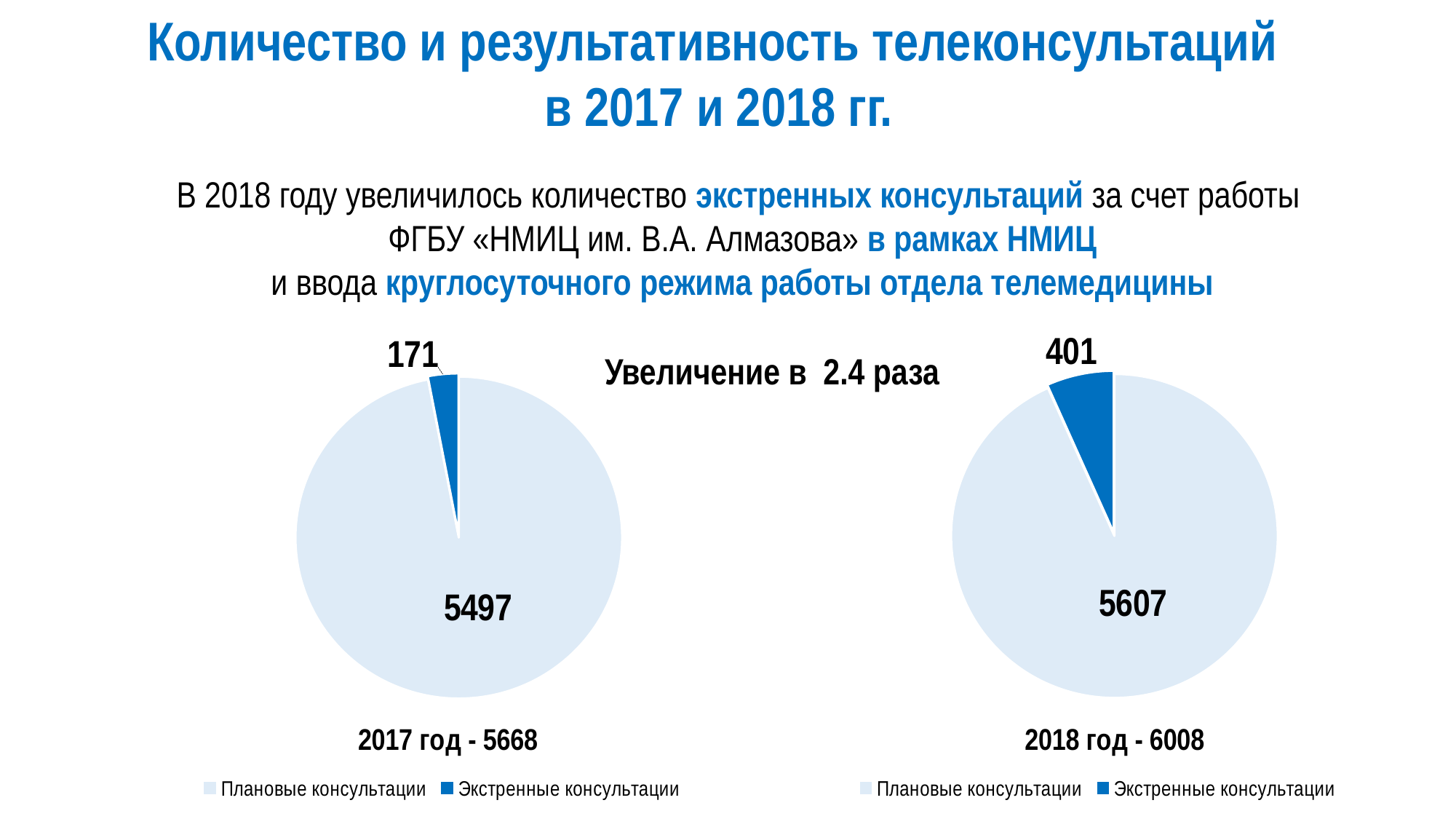
What type of chart is used on this slide for 2017 and 2018? Pie chart How many series does the legend of the 2017 pie chart list? 2 In the 2017 pie chart, which category is the smallest? Экстренные консультации What is the difference between the Экстренные консультации values in the 2018 and 2017 pie charts? 230 In the 2018 pie chart, which category is the largest? Плановые консультации What is the difference between the Плановые консультации values in the 2018 and 2017 pie charts? 110 In the 2018 pie chart, what is the value for Плановые консультации? 5607 Which is larger: Экстренные консультации in the 2017 pie chart or in the 2018 pie chart? 2018 What total is shown under the 2018 pie chart? 2018 год - 6008 In the 2017 pie chart, what is the value for Экстренные консультации? 171 In the 2017 pie chart, what is the value for Плановые консультации? 5497 In the 2018 pie chart, what is the value for Экстренные консультации? 401